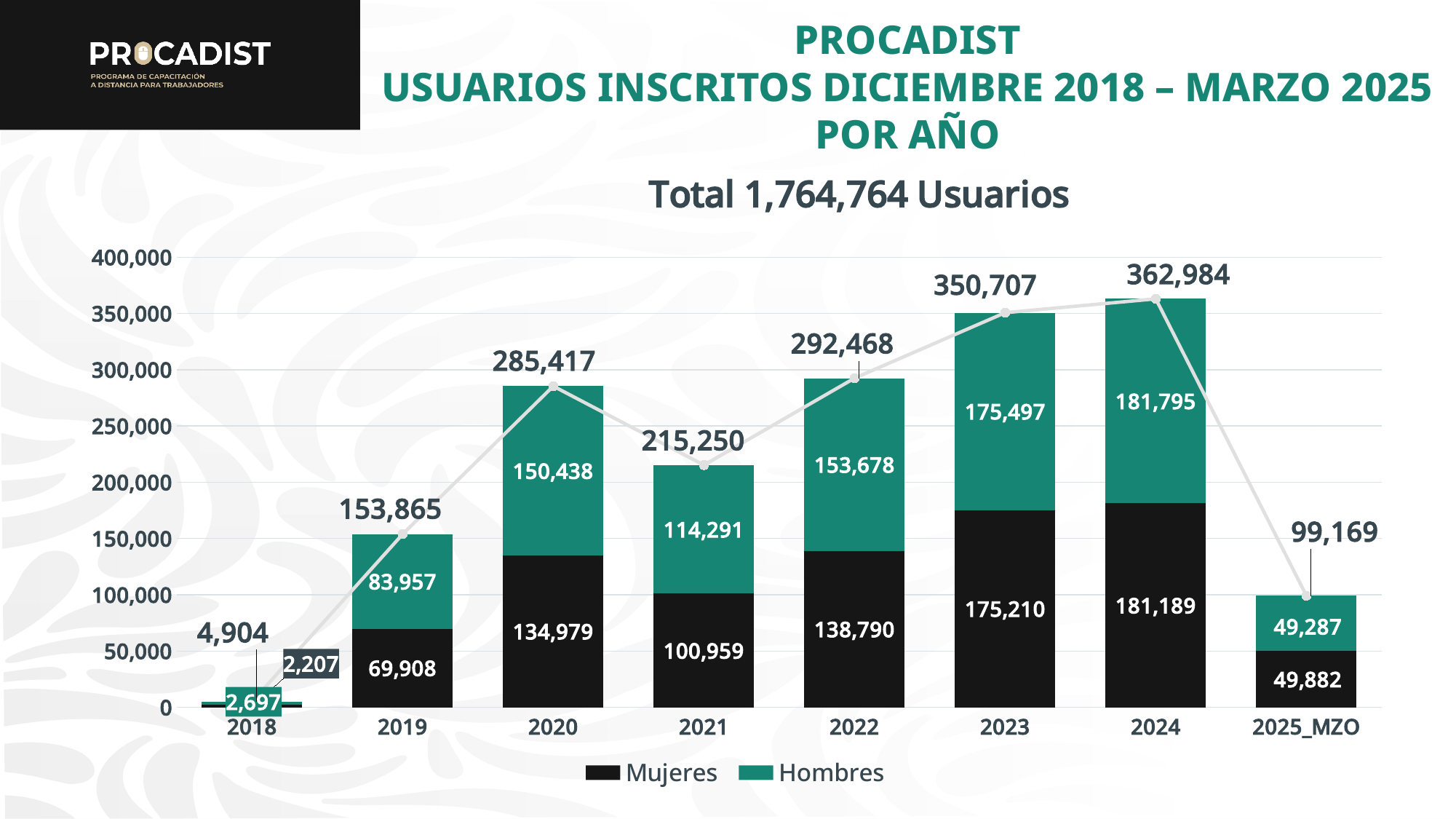
What is the total of the stacked bar for 2021? 215,250 In 2019, which is larger: Mujeres or Hombres? Hombres Which year has the highest total of registered users? 2024 Which year has the lowest total of registered users? 2018 What kind of chart is shown on the slide? Stacked bar chart with a line overlay (combination bar and line chart) What is the total number of users shown for 2024? 362,984 What is the Hombres value for 2022? 153,678 How many series does the legend list? 2 What is the difference between the Hombres and Mujeres values in 2020? 15,459 By how much does the 2024 total exceed the 2023 total? 12,277 How many Mujeres were registered in 2020? 134,979 How many year categories are shown on the x axis? 8